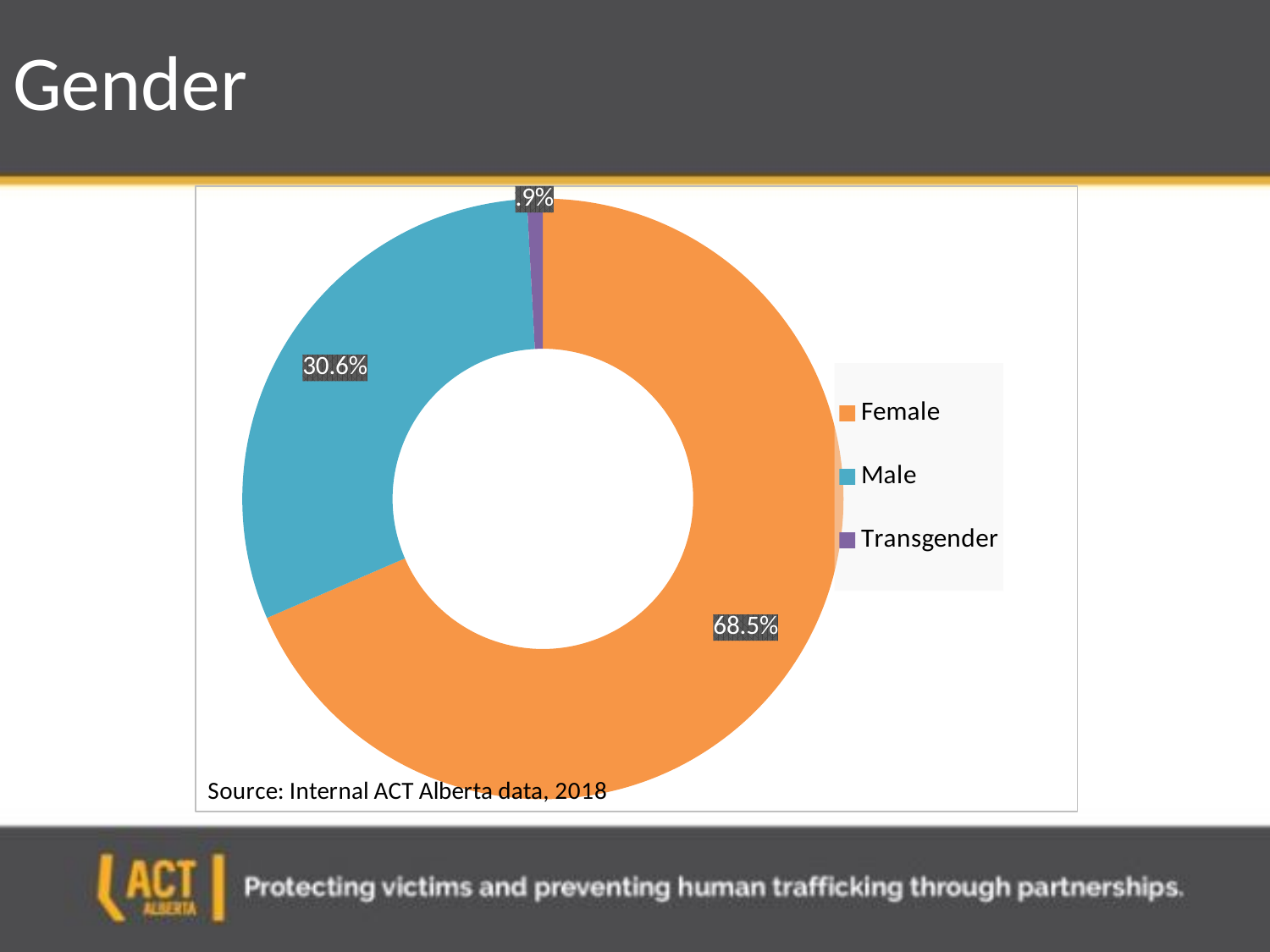
How many categories does the chart show? 3 What is the source cited for the chart data? Internal ACT Alberta data, 2018 What is the title of the slide? Gender Which is larger, the Male share or the Transgender share? Male What percentage of the chart is Transgender? .9% What percentage of the chart is Female? 68.5% What percentage of the chart is Male? 30.6% What kind of chart is shown on the slide? Doughnut (pie) chart Which category has the smallest share of the chart? Transgender What is the difference in percentage points between the Female and Male shares? 37.9 Which category has the largest share of the chart? Female What colour represents Male in the chart? Blue